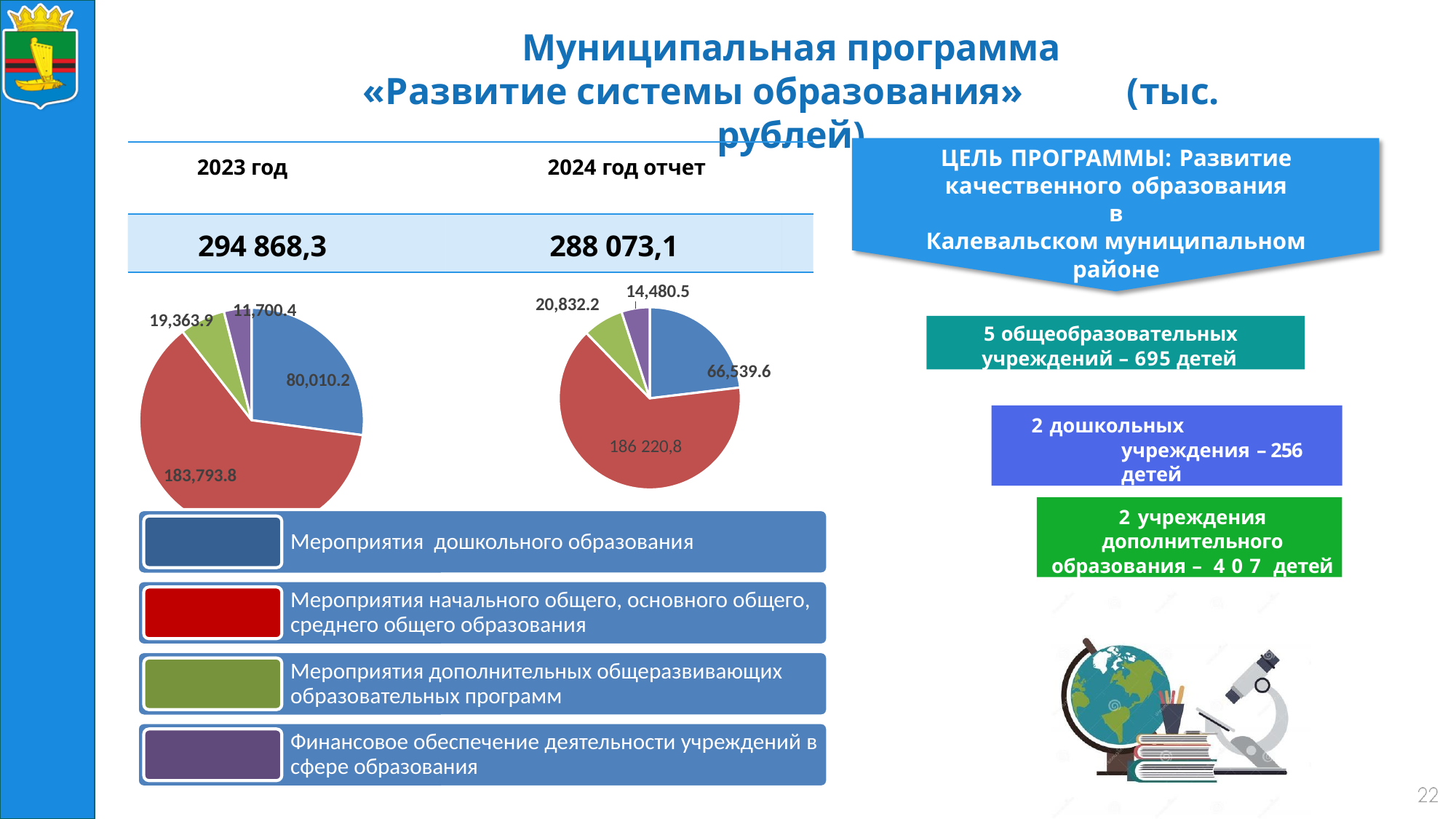
Is the value for Мероприятия дополнительных общеразвивающих образовательных программ larger in the 2023 год chart or the 2024 год отчет chart? 2024 год отчет What is the difference between the 2023 год and 2024 год отчет values for Мероприятия дошкольного образования? 13,470.6 In the 2024 год отчет pie chart, which category has the smallest value? Финансовое обеспечение деятельности учреждений в сфере образования What is the difference between the 2024 год отчет and 2023 год values for Финансовое обеспечение деятельности учреждений в сфере образования? 2,780.1 In the 2023 год pie chart, what is the value for Мероприятия дополнительных общеразвивающих образовательных программ (green slice)? 19,363.9 How many slices does each pie chart on the slide have? 4 In the 2024 год отчет pie chart, what is the value for Финансовое обеспечение деятельности учреждений в сфере образования (purple slice)? 14,480.5 In the 2024 год отчет pie chart, what is the value for Мероприятия начального общего, основного общего, среднего общего образования (red slice)? 186 220,8 In the 2023 год pie chart, what is the value for Мероприятия дошкольного образования (blue slice)? 80,010.2 In the 2023 год pie chart, which category has the largest value? Мероприятия начального общего, основного общего, среднего общего образования How many entries does the legend below the pie charts list? 4 What kind of chart is used for the 2023 год data on the slide? pie chart